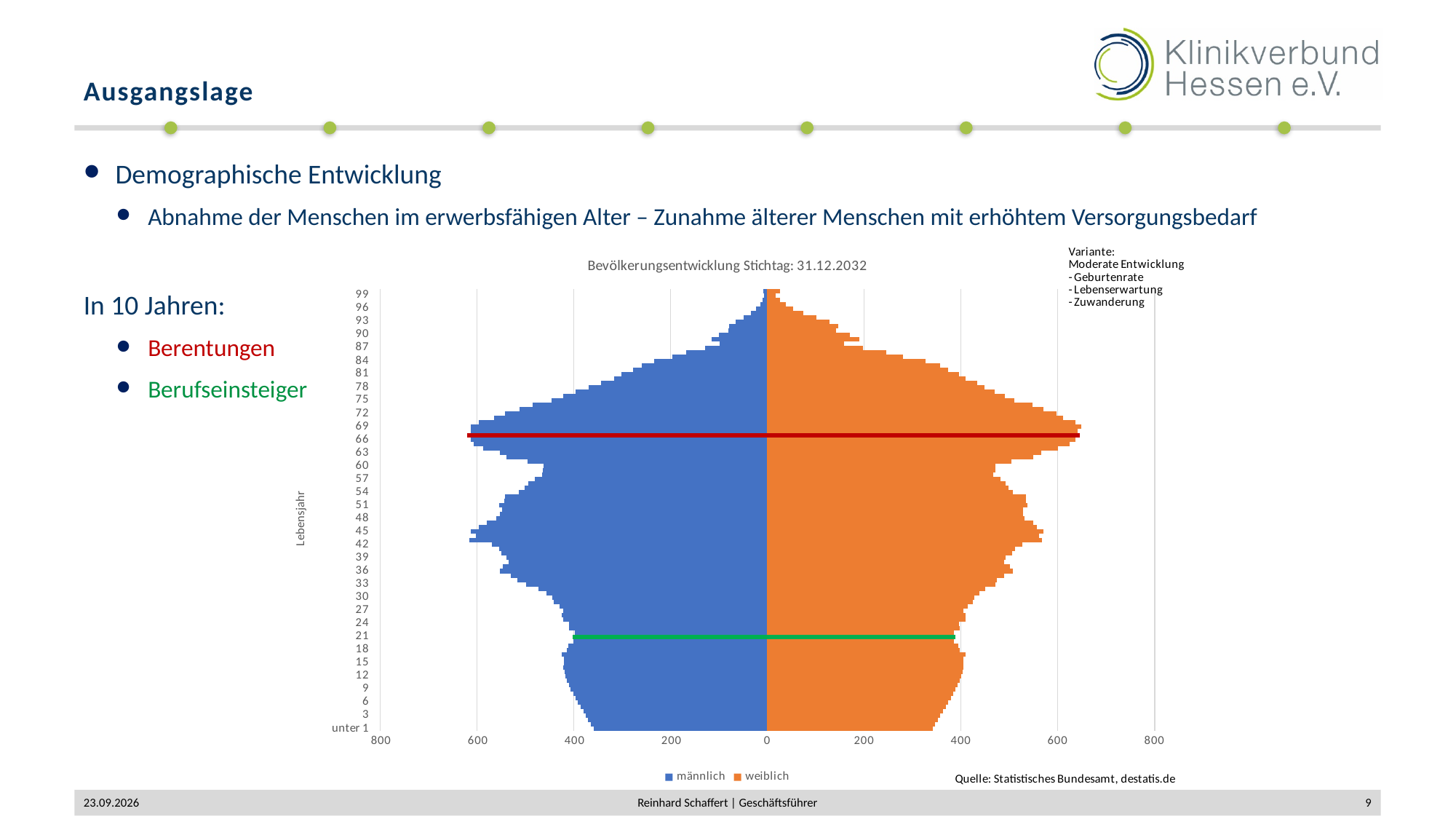
What is the title of the chart? Bevölkerungsentwicklung Stichtag: 31.12.2032 How many series does the chart legend list? 2 What kind of chart is shown on the slide? bar chart Is the value for männlich at age 30 greater or less than 600? less At age 90, which series has the larger value, männlich or weiblich? weiblich Is the value for männlich at age 90 greater or less than 200? less Is the value for weiblich at age 66 greater or less than 600? greater At age 81, which series has the larger value, männlich or weiblich? weiblich Which series is shown in orange in the chart? weiblich